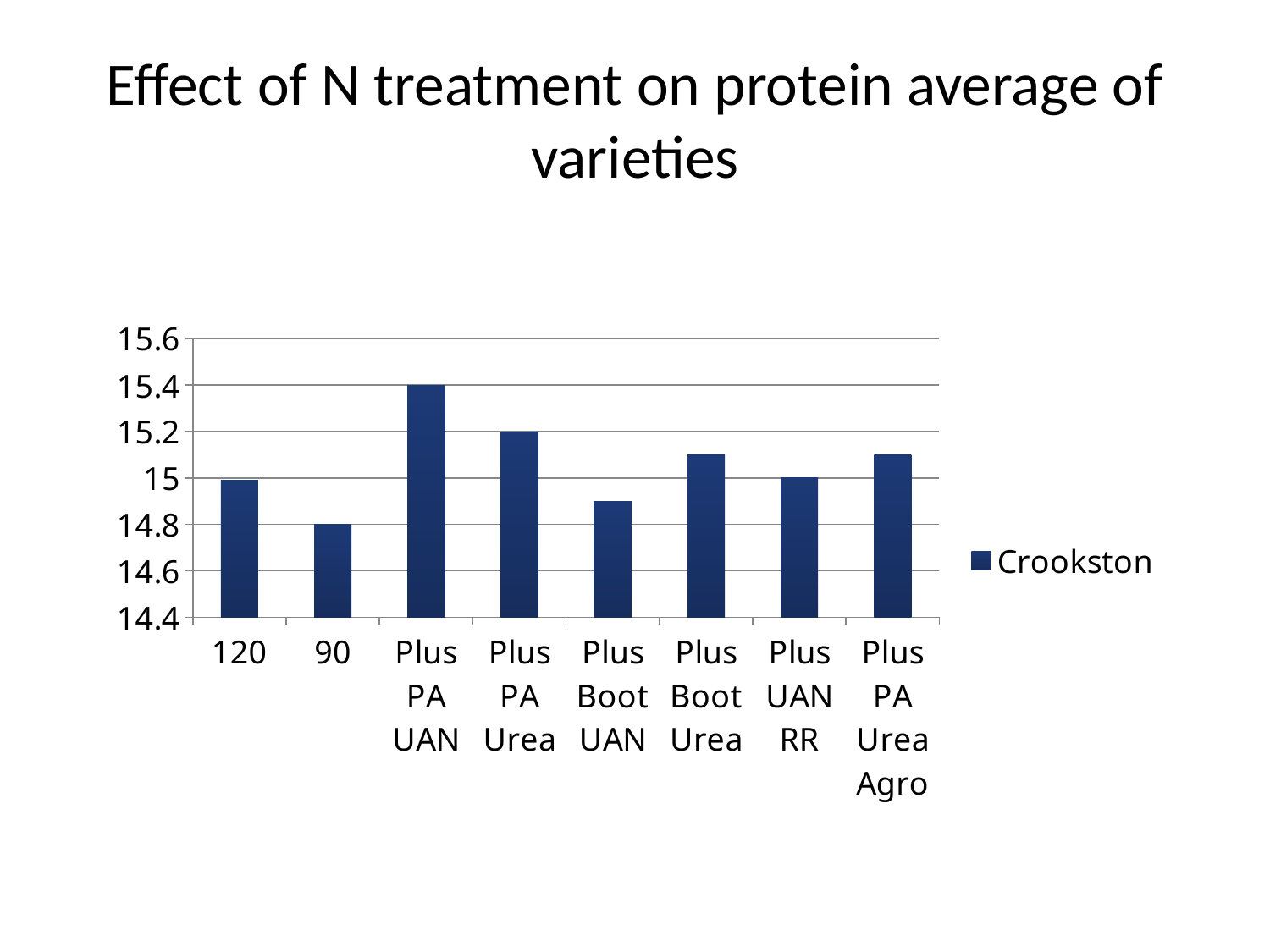
Is the value for Plus Boot UAN greater or less than 15? less Which treatment has the lowest protein average? 90 What type of chart is shown on the slide? bar chart What is the protein average for the 90 treatment? 14.8 What series name is shown in the legend? Crookston How many treatment categories are shown on the x axis? 8 Which treatment has the highest protein average? Plus PA UAN Which is larger, the value for Plus PA Urea or the value for Plus Boot UAN? Plus PA Urea What is the protein average for the Plus PA UAN treatment? 15.4 What is the protein average for the Plus PA Urea treatment? 15.2 How many series does the legend list? 1 What is the difference between the Plus PA UAN and Plus PA Urea values? 0.2